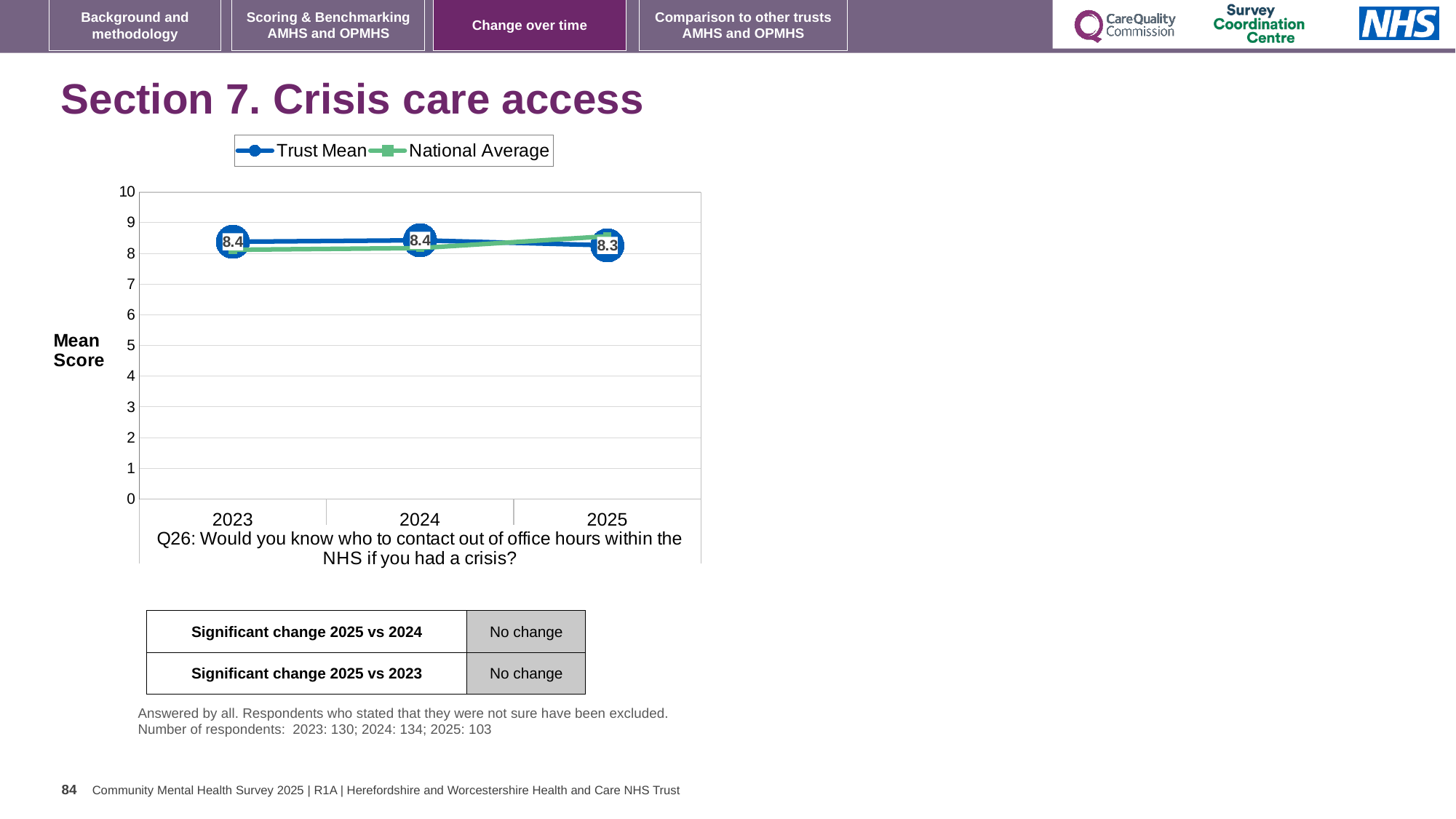
In which year is the Trust Mean lowest? 2025 What is the Trust Mean value for 2023? 8.4 What kind of chart is shown on the slide? Line chart What is the difference between the Trust Mean in 2023 and in 2025? 0.1 Is the National Average value for 2023 greater or less than 9? less Is the National Average value for 2025 greater or less than 5? greater What is the Trust Mean value for 2024? 8.4 How many years are shown on the x axis of the chart? 3 Which is larger, the Trust Mean for 2024 or the Trust Mean for 2025? 2024 What is the label on the y axis of the chart? Mean Score How many series does the chart legend list? 2 What is the Trust Mean value for 2025? 8.3